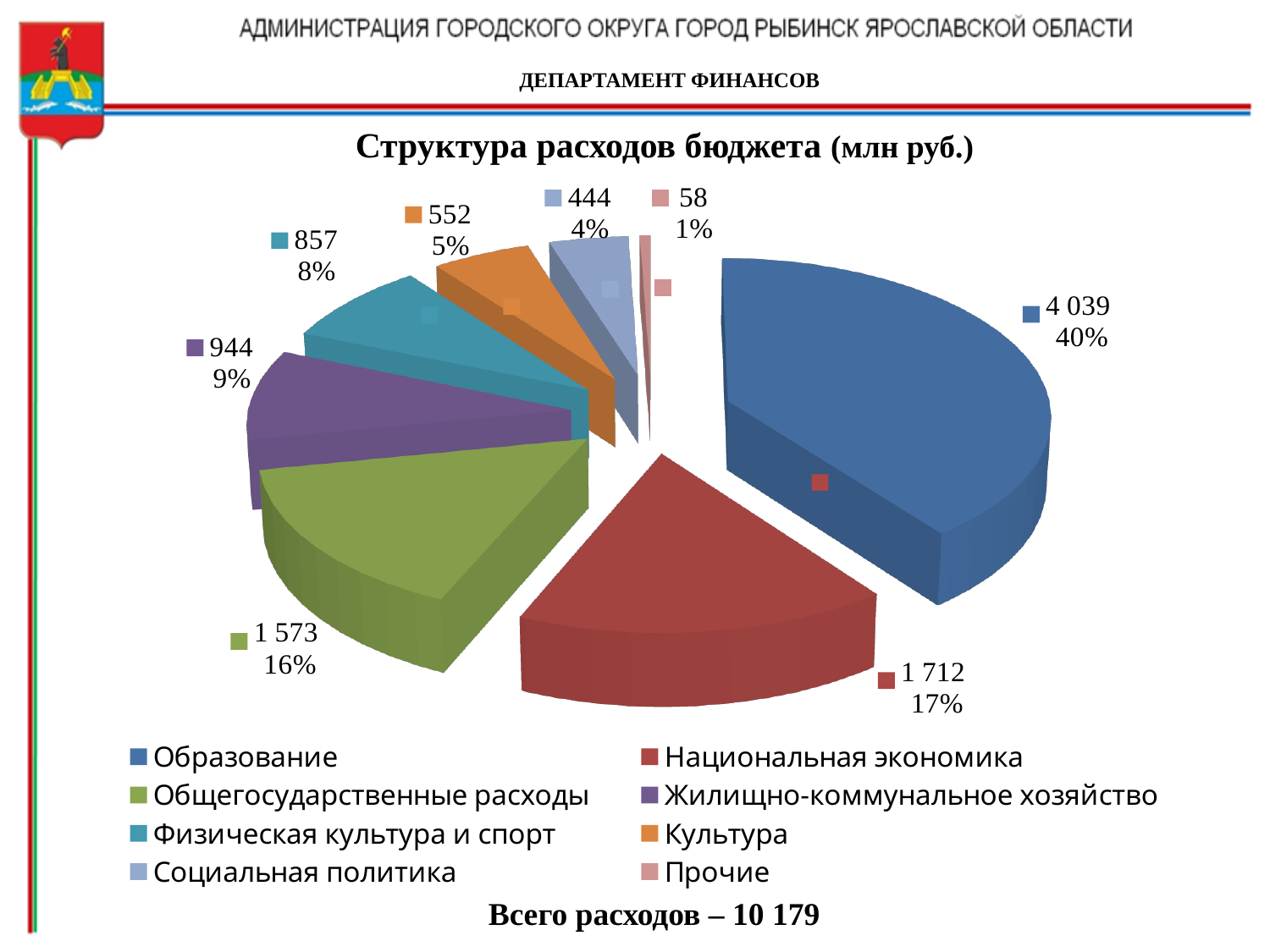
What is the value for Национальная экономика? 1 712 What is the value for Образование? 4 039 Which category has the smallest slice? Прочие How many categories does the pie chart have? 8 What share of the pie does Общегосударственные расходы take? 16% What kind of chart is shown on the slide? pie chart What is the value for Жилищно-коммунальное хозяйство? 944 What is the difference between the values for Образование and Национальная экономика? 2 327 What share of the pie does Социальная политика take? 4% Which category has the largest slice? Образование Which is larger, the value for Физическая культура и спорт or the value for Культура? Физическая культура и спорт What is the title of the chart? Структура расходов бюджета (млн руб.)